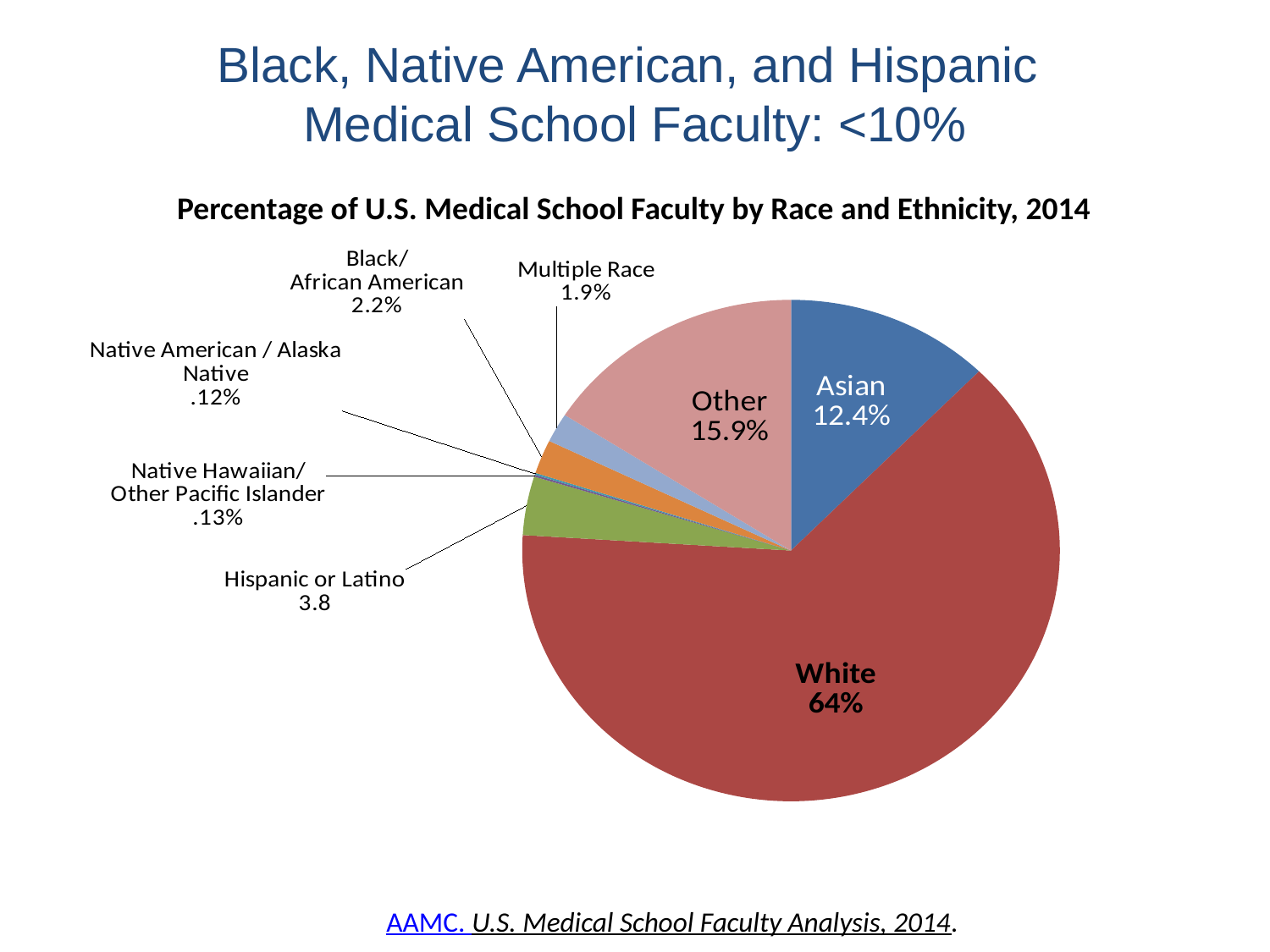
What kind of chart is shown on the slide? Pie chart How many slices does the pie chart have? 8 What is the title of the pie chart? Percentage of U.S. Medical School Faculty by Race and Ethnicity, 2014 What is the difference between the White and Asian percentages? 51.6% Which is larger, the Other slice or the Asian slice? Other What percentage is shown for Black/African American? 2.2% What is the value shown for the Other slice? 15.9% What percentage of U.S. medical school faculty is White according to the pie chart? 64% What percentage is shown for Multiple Race? 1.9% What value is labeled for Hispanic or Latino? 3.8 Which category has the largest slice of the pie? White What is the value shown for Asian in the pie chart? 12.4%